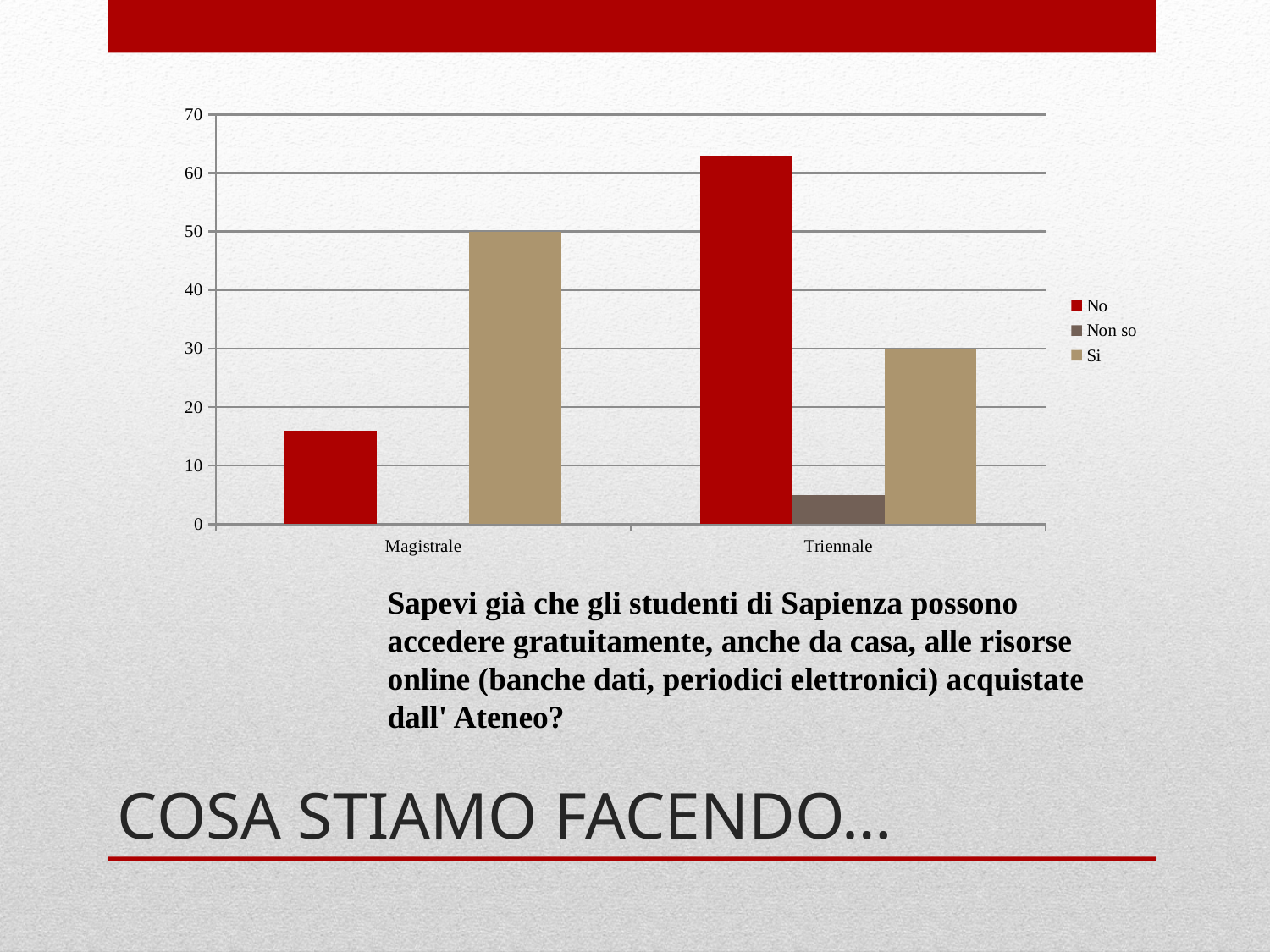
Is the value of the Non so series for Triennale greater or less than 10? less How many categories are shown on the x axis? 2 What is the value of the Si series for Triennale? 30 What is the difference between the Si value for Magistrale and the Si value for Triennale? 20 Which is larger: the Si value for Magistrale or the Si value for Triennale? Magistrale Is the value of the No series for Magistrale greater or less than 20? less What is the value of the Si series for Magistrale? 50 Is the value of the No series for Triennale greater or less than 60? greater Which series has the highest value for Magistrale? Si Which series has the highest value for Triennale? No How many series does the legend list? 3 What kind of chart is shown on the slide? bar chart